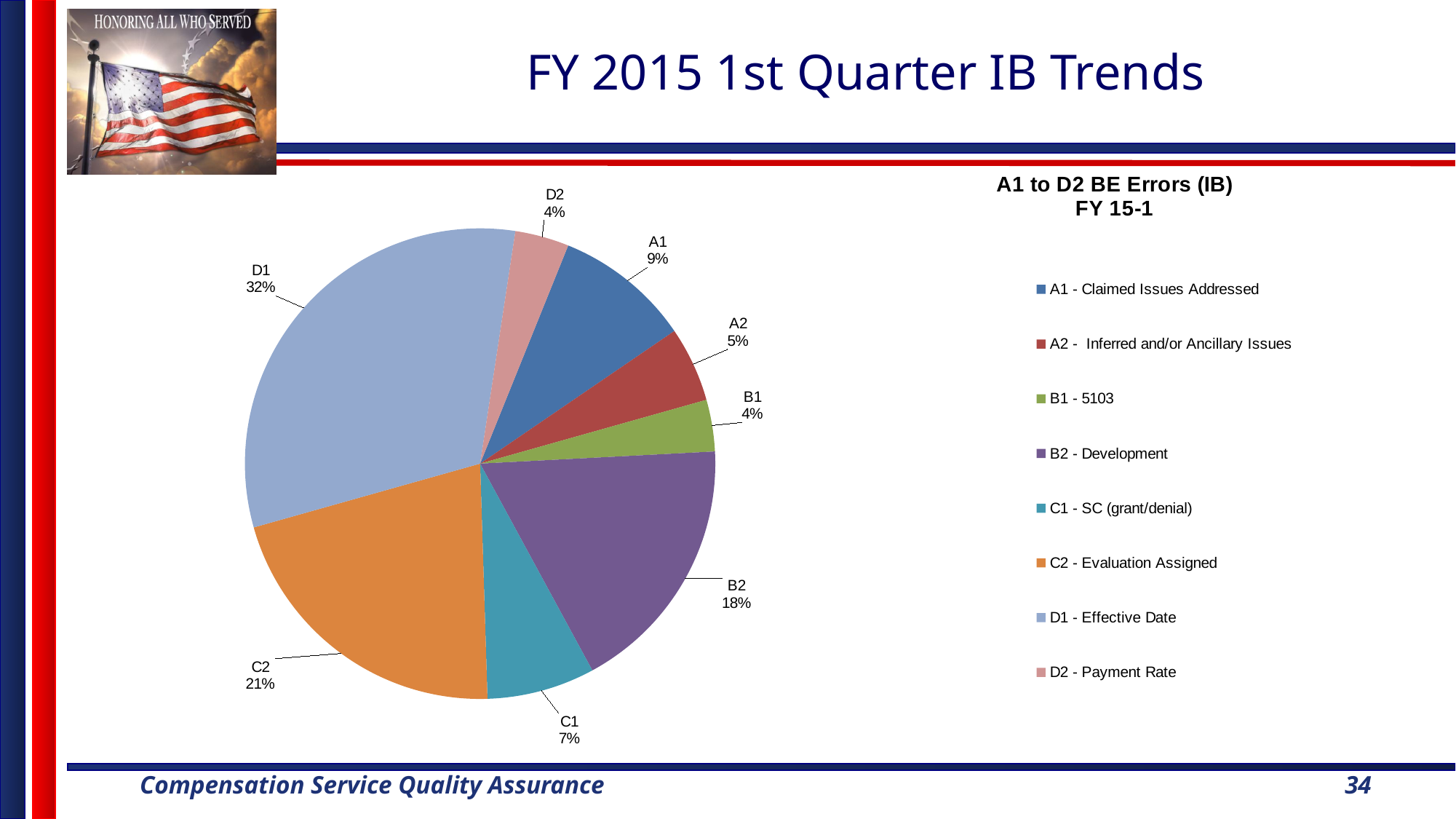
Which is larger, the A1 slice or the A2 slice? A1 What percentage is shown for B2? 18% How many entries does the legend list? 8 What is the chart's title? A1 to D2 BE Errors (IB) FY 15-1 What percentage is shown for C1? 7% What is the difference in percentage points between C2 and B2? 3 How many slices does the pie chart have? 8 What is the combined percentage of D1 and C2? 53% Which category has the largest slice of the pie? D1 What share of the pie does D1 represent? 32% According to the legend, what does D2 stand for? Payment Rate What kind of chart is shown on the slide? pie chart